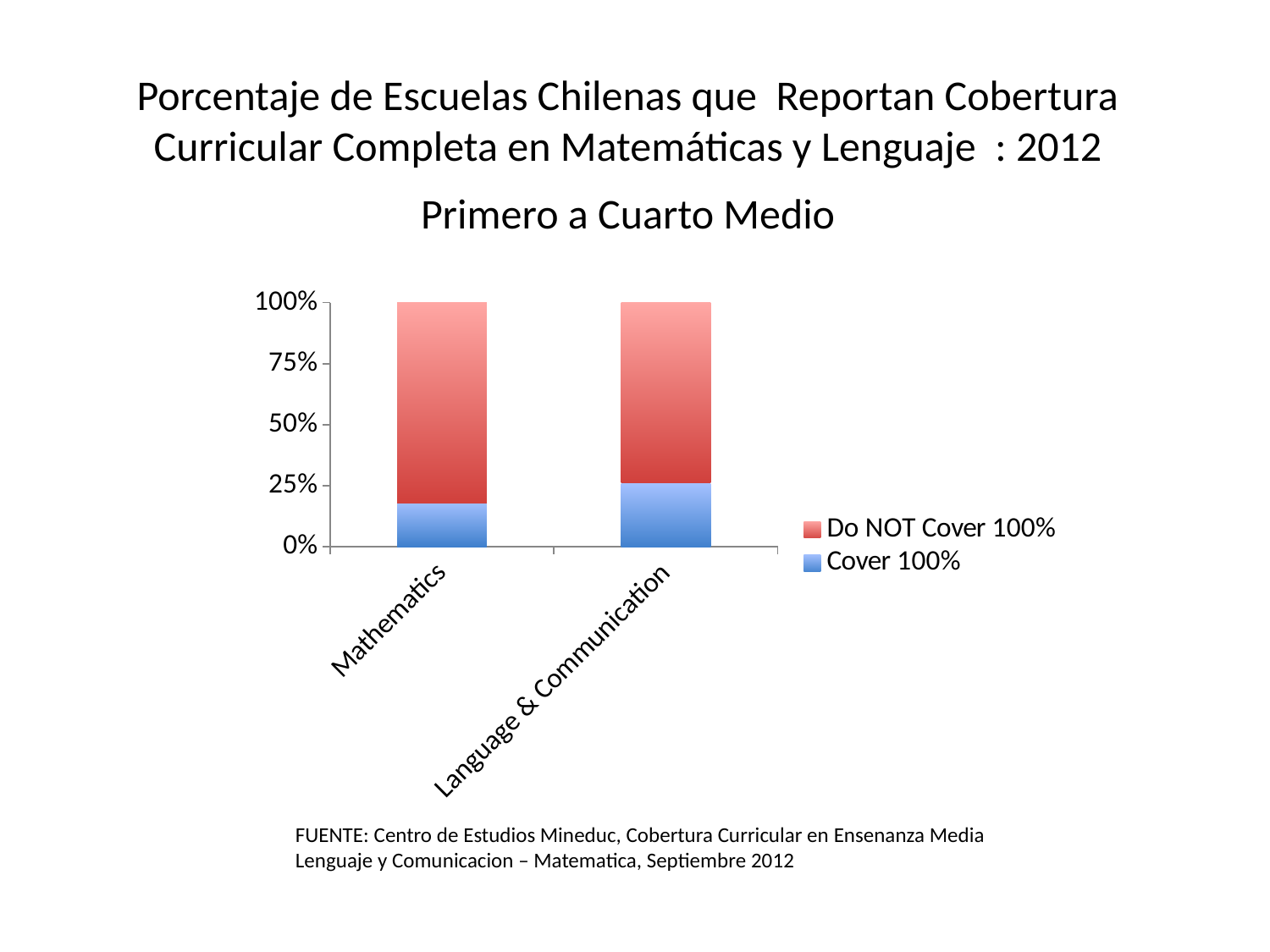
Which category has the larger 'Cover 100%' value, Mathematics or Language & Communication? Language & Communication What kind of chart is shown on the slide? stacked bar chart Is the 'Do NOT Cover 100%' value for Mathematics greater or less than 75%? greater Which legend entry is shown in blue? Cover 100% Which category has the larger 'Do NOT Cover 100%' value, Mathematics or Language & Communication? Mathematics Is the 'Cover 100%' value for Mathematics greater or less than 25%? less Is the 'Do NOT Cover 100%' value for Language & Communication greater or less than 50%? greater What is the total height of the stacked bar for Mathematics? 100% Which legend entry is shown in red? Do NOT Cover 100% How many series does the chart's legend list? 2 How many categories are shown on the x axis of the chart? 2